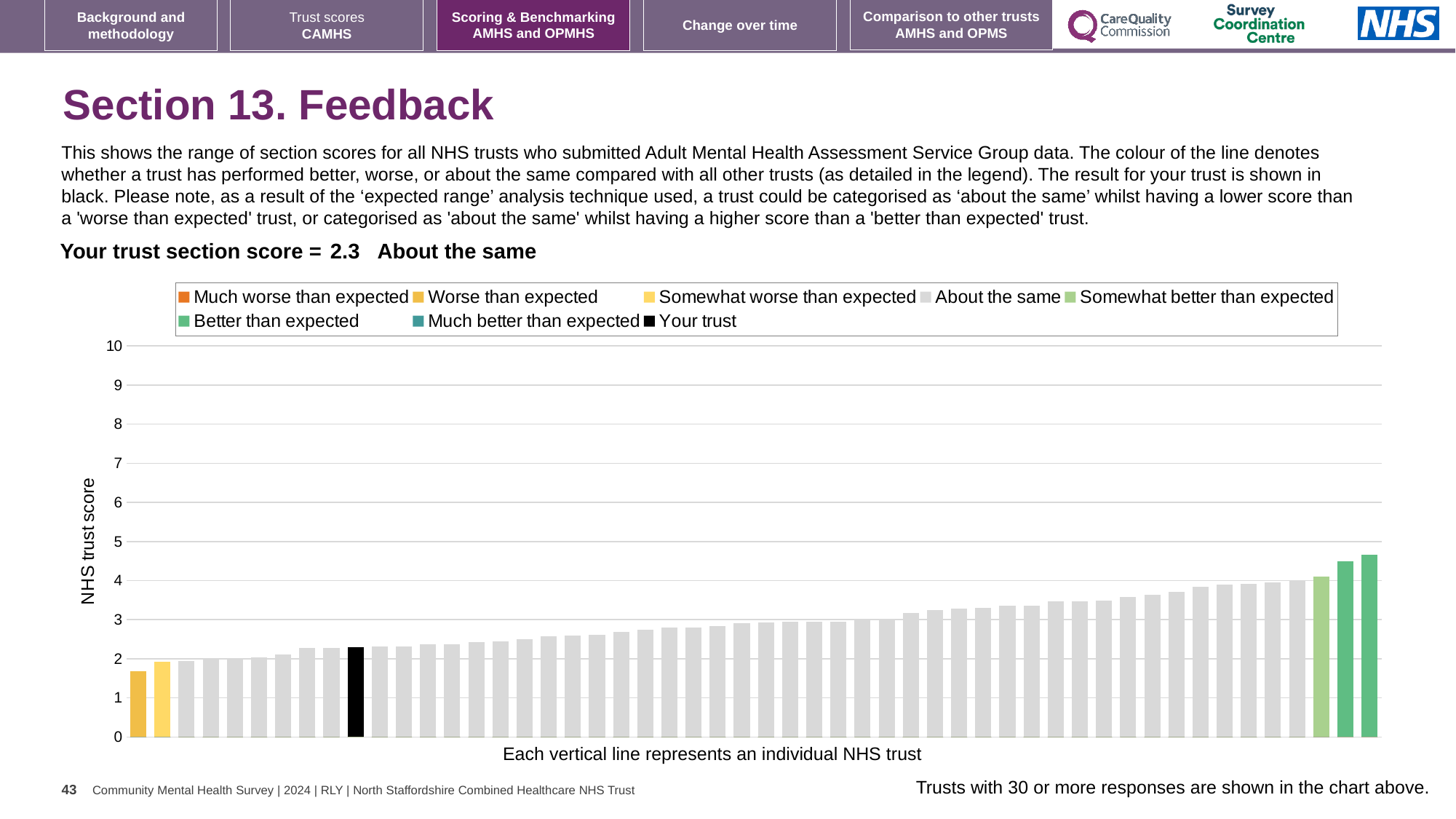
Which legend category does the tallest bar belong to? Better than expected What is the label on the vertical axis of the chart? NHS trust score Is the tallest bar in the chart greater or less than 5? less Is the tallest bar in the chart greater or less than 4? greater Which is larger, the bar for your trust or the leftmost bar? Your trust What is your trust's section score shown on the slide? 2.3 What kind of chart is shown on the slide? bar chart Do the bar values rise or fall from left to right along the x axis? rise Which legend category does the shortest bar belong to? Worse than expected Is the leftmost (shortest) bar greater or less than 2? less How many entries does the chart legend list? 8